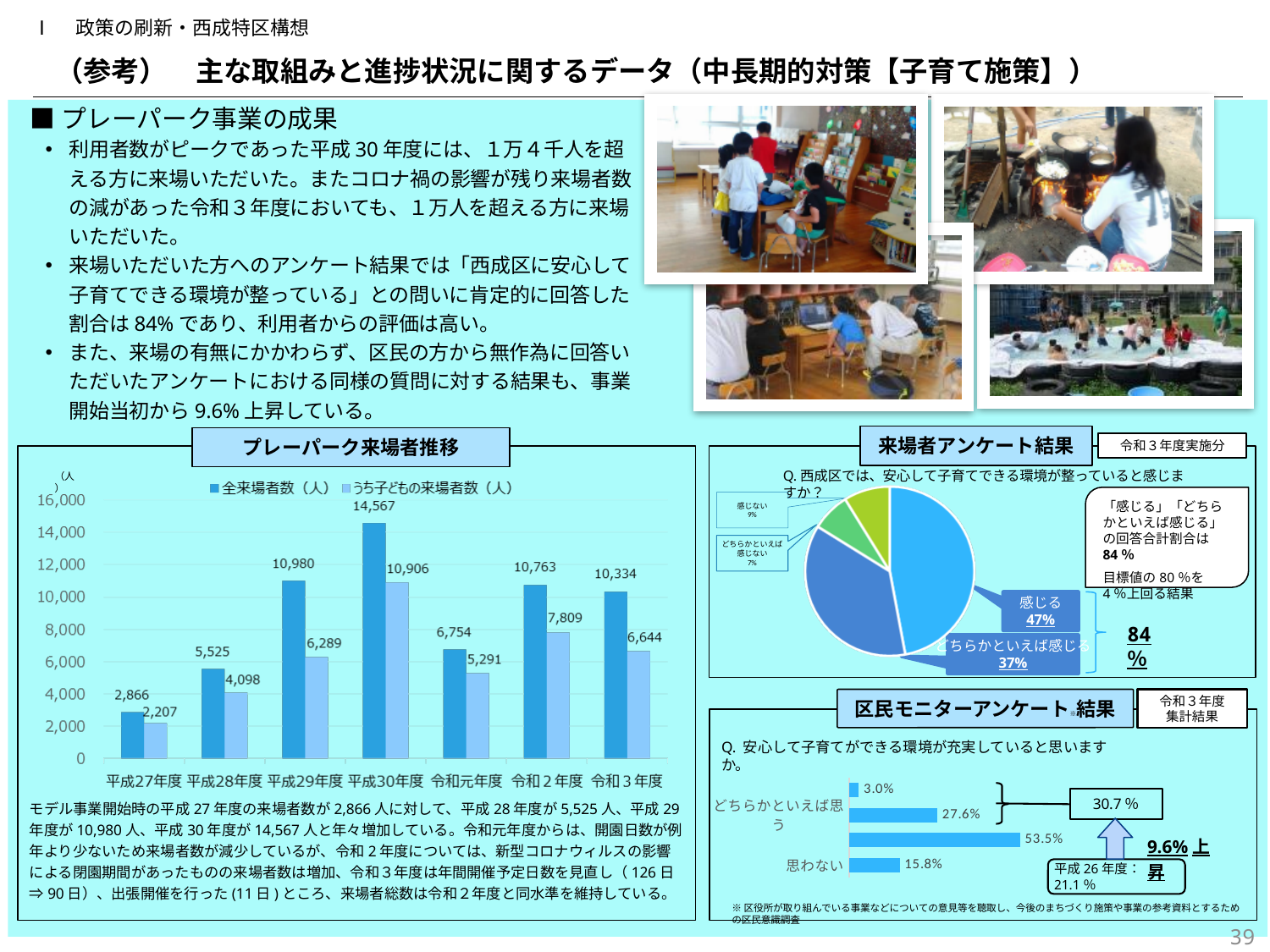
In the 区民モニターアンケート結果 chart, what is the value for 思わない? 15.8% In the 来場者アンケート結果 pie chart, what share of respondents answered 感じる? 47% In the プレーパーク来場者推移 chart, what is the difference between the 全来場者数 for 平成28年度 and 平成27年度? 2,659 In the プレーパーク来場者推移 chart, what is the 全来場者数 for 平成30年度? 14,567 In the 来場者アンケート結果 pie chart, what is the combined share of 感じる and どちらかといえば感じる? 84% In the プレーパーク来場者推移 chart, how many series does the legend list? 2 In the プレーパーク来場者推移 chart, which year has the lowest うち子どもの来場者数? 平成27年度 In the プレーパーク来場者推移 chart, which is larger: the 全来場者数 for 令和２年度 or for 令和３年度? 令和２年度 In the プレーパーク来場者推移 chart, which year has the highest 全来場者数? 平成30年度 In the プレーパーク来場者推移 chart, how many fiscal years are shown on the x axis? 7 In the プレーパーク来場者推移 chart, what is the うち子どもの来場者数 for 令和２年度? 7,809 What kind of chart is the プレーパーク来場者推移 chart? bar chart